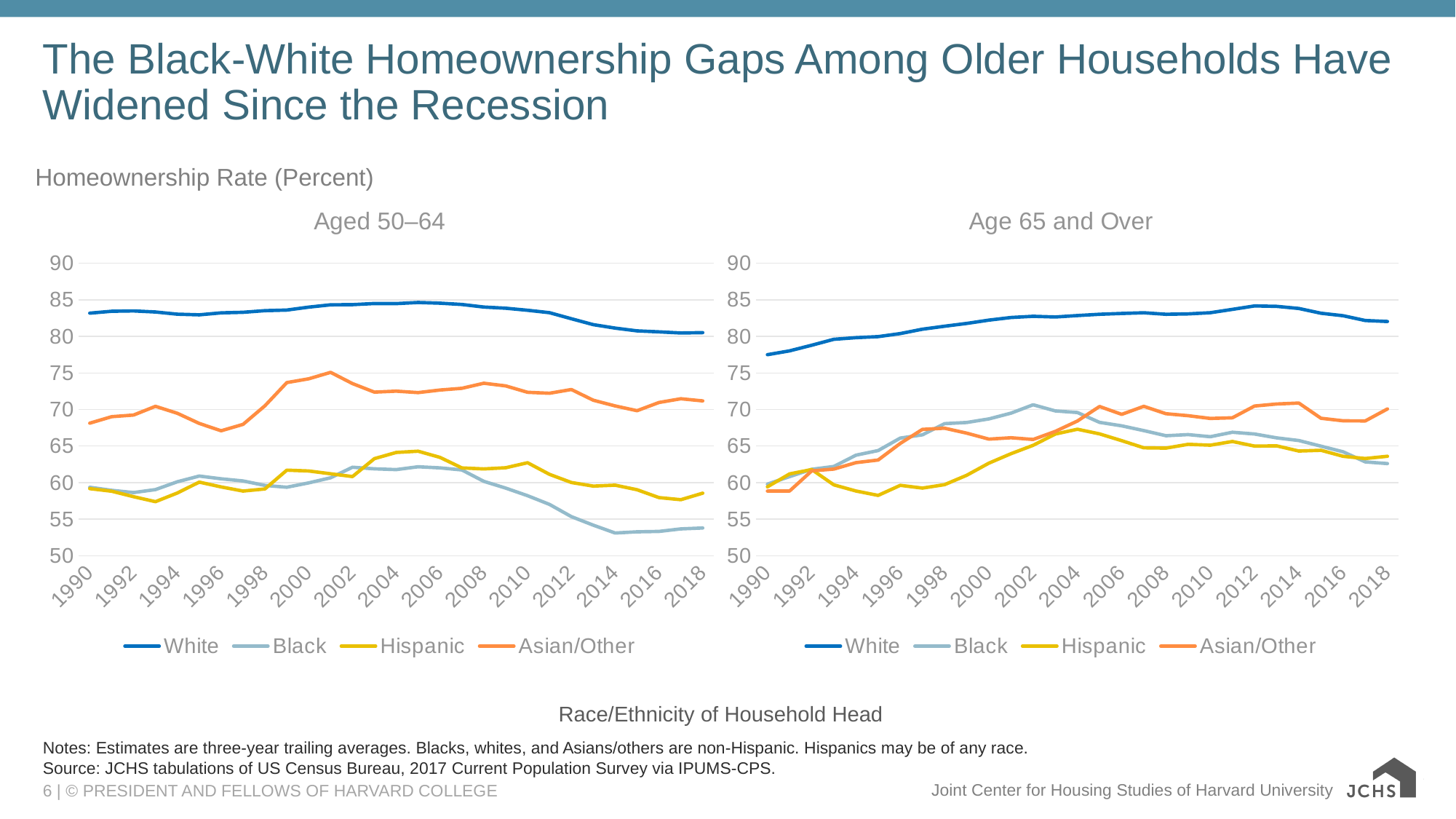
In the Aged 50–64 chart, which series has the highest homeownership rate across all years shown? White In the Age 65 and Over chart, does the White series rise or fall between 1990 and 2002? Rise In the Age 65 and Over chart, is the value for Hispanic in 1995 greater or less than 60? less In the Aged 50–64 chart, is the value for Black in 2014 greater or less than 55? less In the Aged 50–64 chart, is the value for Asian/Other in 1999 greater or less than 70? greater In the Age 65 and Over chart, which is higher in 2018, Asian/Other or Black? Asian/Other How many series does the legend of the Age 65 and Over chart list? 4 In the Aged 50–64 chart, which is higher in 2018, Hispanic or Black? Hispanic What type of chart is used for the Aged 50–64 panel? Line chart In the Aged 50–64 chart, which series has the lowest homeownership rate in 2018? Black In the Aged 50–64 chart, does the Black series rise or fall between 2010 and 2014? Fall